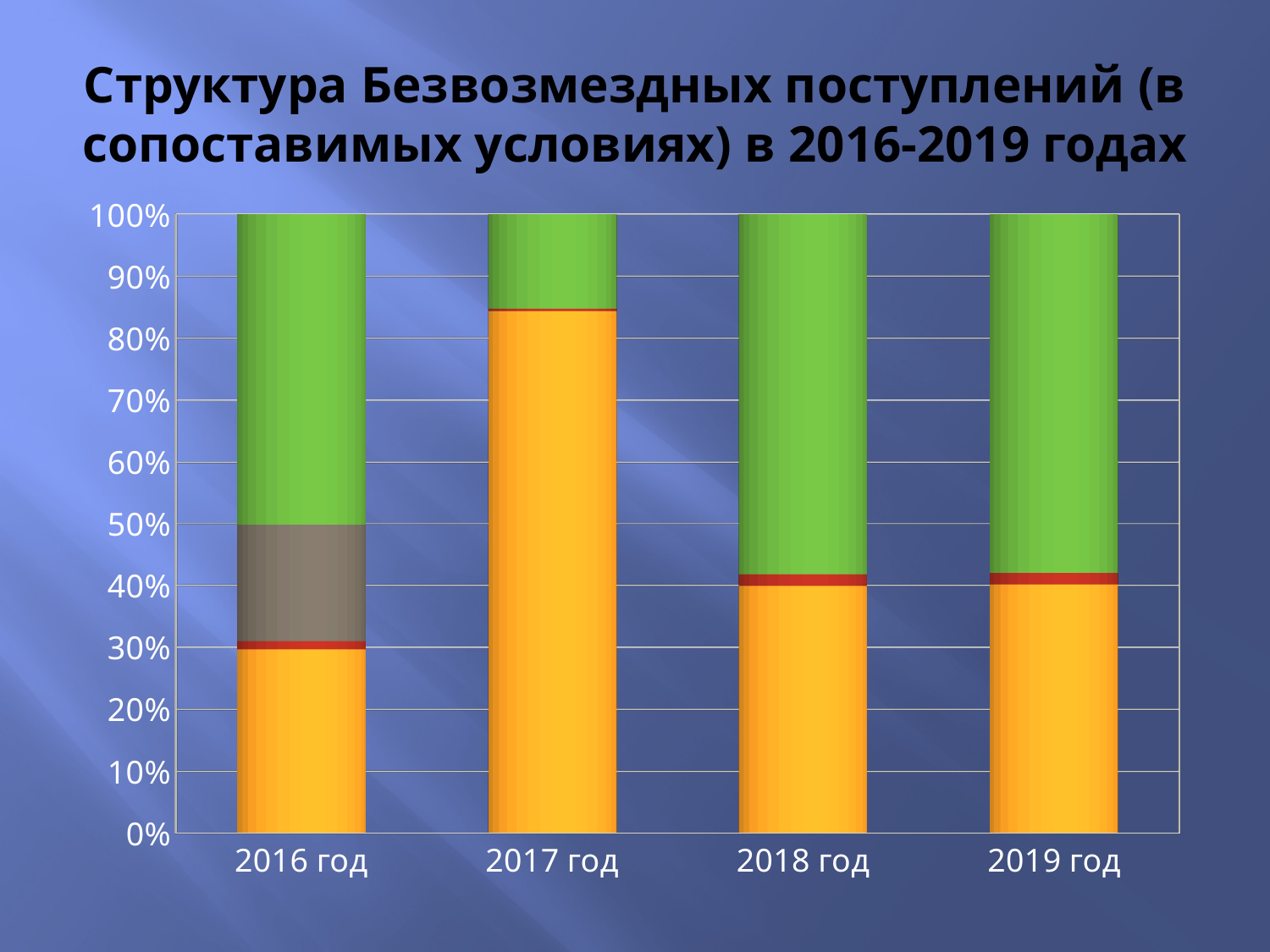
In which year is the green segment the smallest? 2017 год Is the top of the orange segment for 2018 год greater or less than 50%? less What is the maximum value shown on the y axis? 100% Is the top of the orange segment for 2017 год greater or less than 80%? greater Which year's bar contains a grey segment? 2016 год Which has the larger orange segment, 2017 год or 2016 год? 2017 год What kind of chart is shown on the slide? stacked bar chart In which year is the orange segment the smallest? 2016 год Is the top of the orange segment for 2019 год greater or less than 30%? greater How many years (categories) are shown on the x axis? 4 In which year is the orange segment the largest? 2017 год